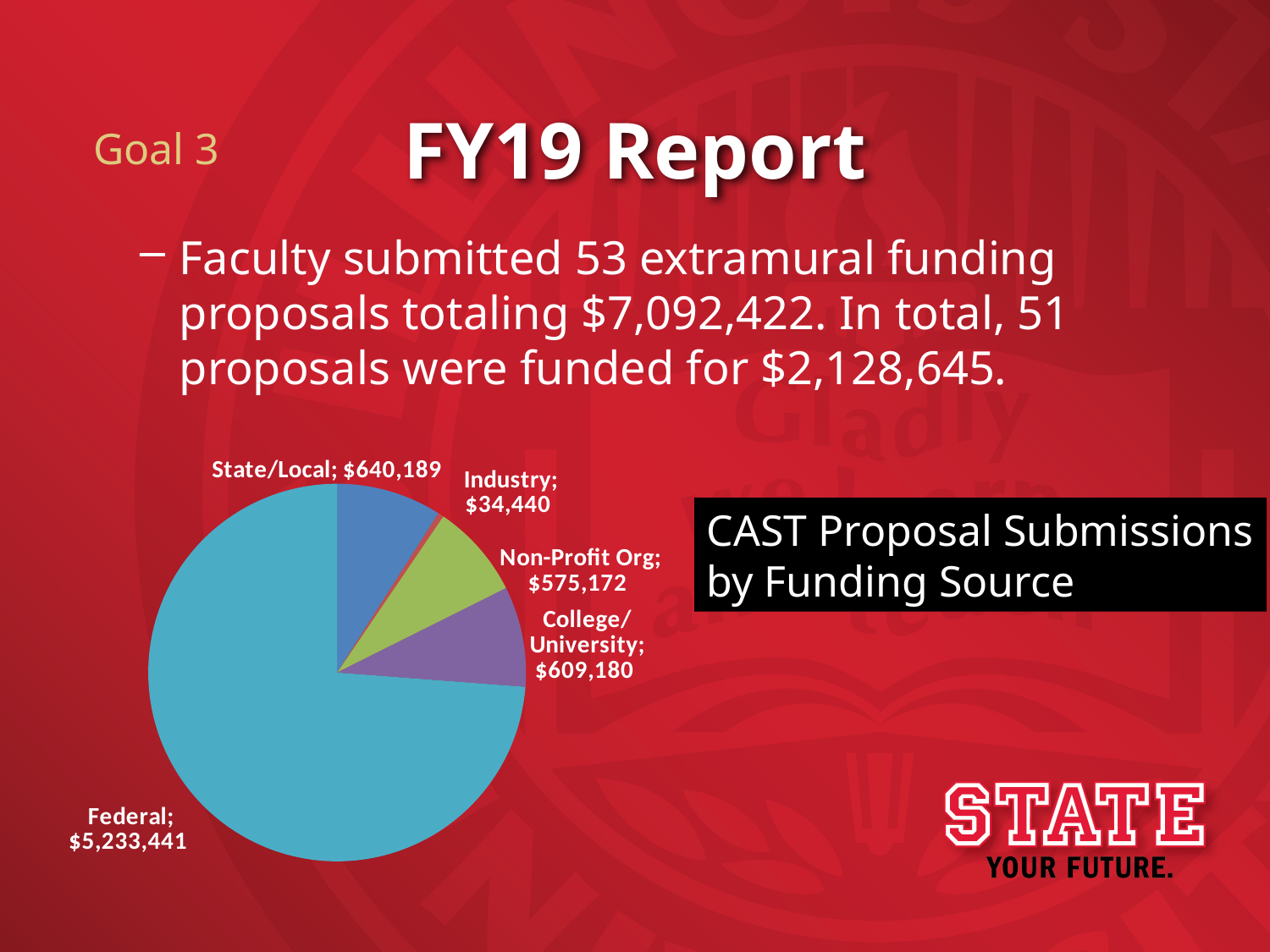
What is the difference between the Federal value and the State/Local value? $4,593,252 What is the value for Industry in the pie chart? $34,440 What is the value for Non-Profit Org in the pie chart? $575,172 What is the difference between the Non-Profit Org value and the Industry value? $540,732 How many funding sources are shown in the pie chart? 5 What is the title of the chart? CAST Proposal Submissions by Funding Source Which funding source has the smallest slice of the pie chart? Industry What type of chart is shown on the slide? pie chart Which is larger, the value for State/Local or the value for College/University? State/Local What is the value for Federal in the pie chart? $5,233,441 Which funding source has the largest slice of the pie chart? Federal What is the value for College/University in the pie chart? $609,180